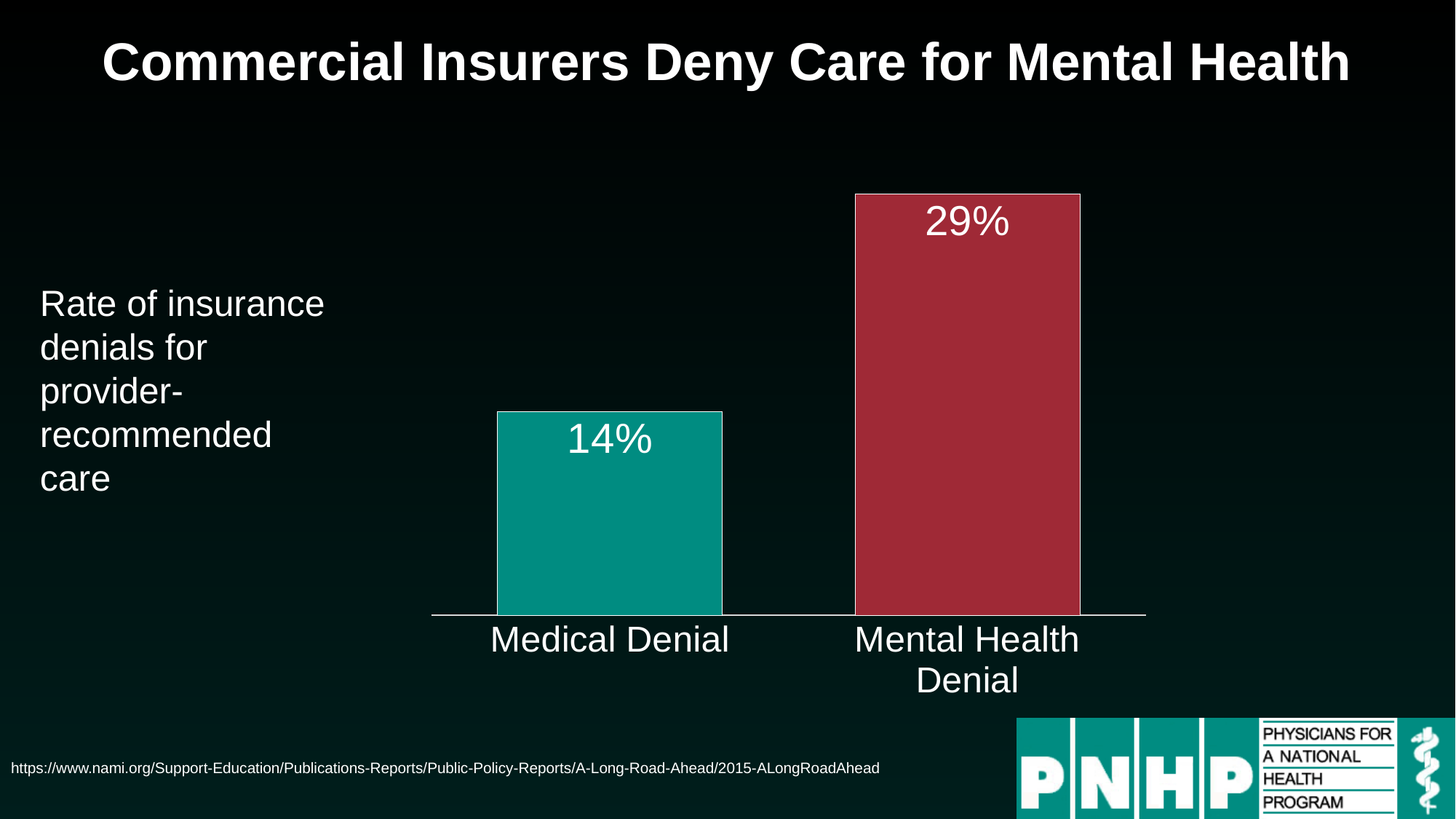
What is the value for Mental Health Denial? 29% Which is larger, the Medical Denial rate or the Mental Health Denial rate? Mental Health Denial How many categories are shown in the chart? 2 What colour is the Mental Health Denial bar? Red Which category has the highest denial rate? Mental Health Denial What kind of chart is shown on the slide? Bar chart Which category has the lowest denial rate? Medical Denial What is the value for Medical Denial? 14% What is the title of the slide? Commercial Insurers Deny Care for Mental Health What is the difference between the Mental Health Denial rate and the Medical Denial rate? 15%